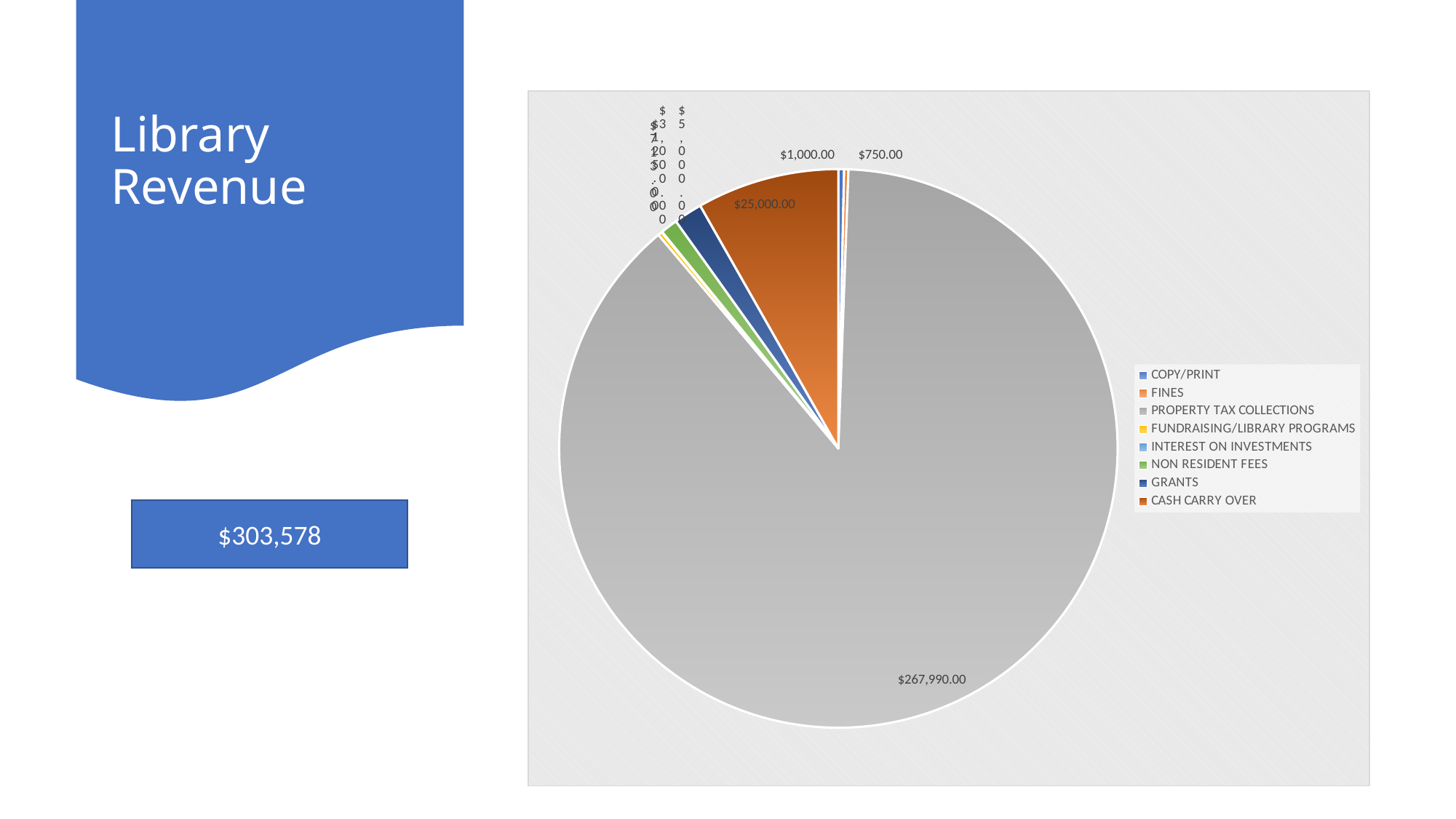
Which is larger in the pie chart, CASH CARRY OVER or GRANTS? CASH CARRY OVER How many categories does the legend of the pie chart list? 8 Which category has the largest slice in the pie chart? PROPERTY TAX COLLECTIONS What kind of chart is shown on the slide? pie chart What is the value shown for CASH CARRY OVER in the pie chart? $25,000.00 What colour is used for PROPERTY TAX COLLECTIONS in the pie chart legend? gray What is the title shown on the slide next to the pie chart? Library Revenue Which is larger in the pie chart, PROPERTY TAX COLLECTIONS or CASH CARRY OVER? PROPERTY TAX COLLECTIONS What is the value shown for PROPERTY TAX COLLECTIONS in the pie chart? $267,990.00 What is the difference between the PROPERTY TAX COLLECTIONS value and the CASH CARRY OVER value in the pie chart? $242,990.00